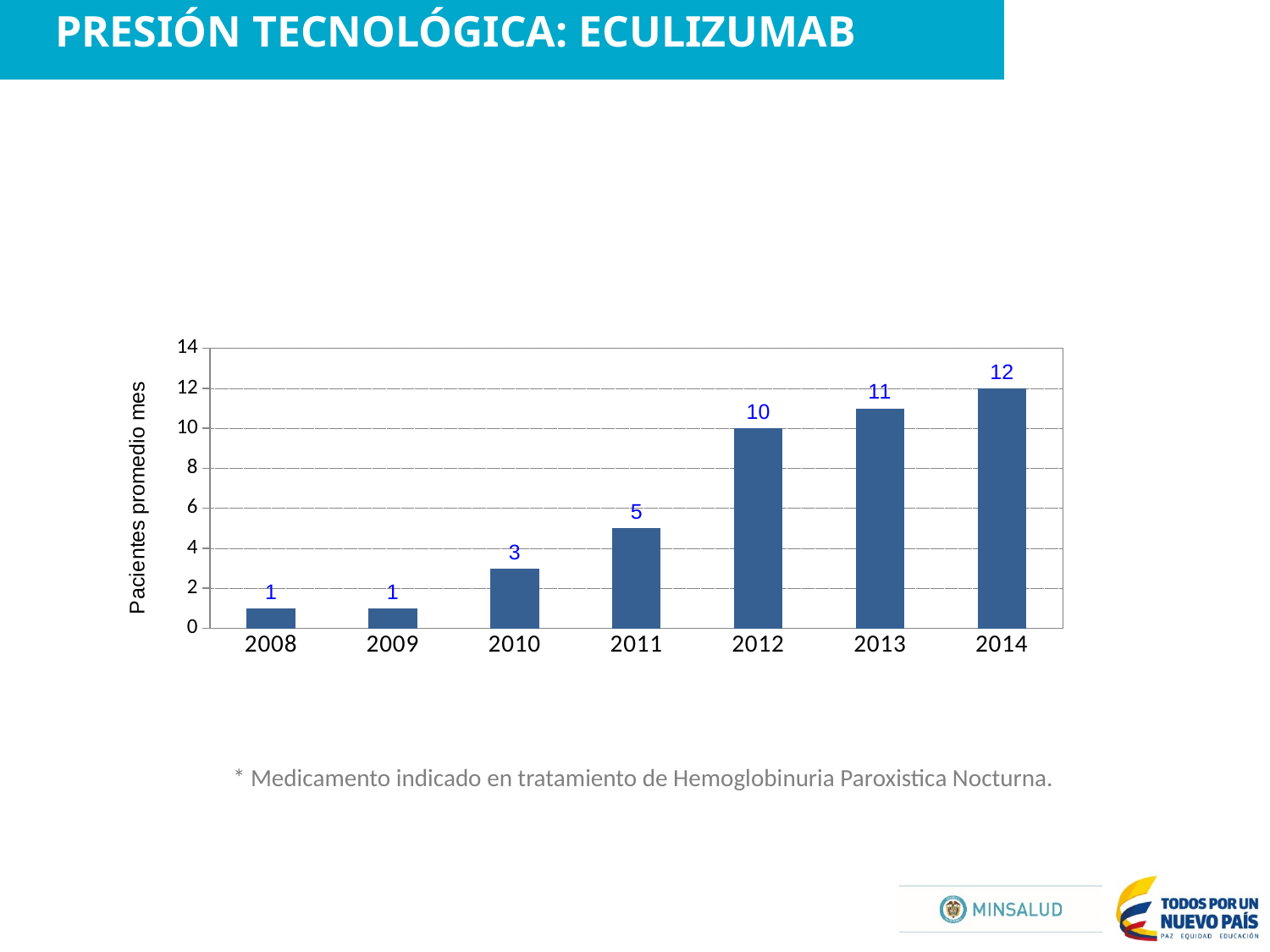
Which year has the highest value? 2014 What is the label of the y axis? Pacientes promedio mes What is the difference between the values for 2013 and 2012? 1 What is the value for 2010? 3 What kind of chart is shown on the slide? bar chart Is the value for 2013 greater or less than 8? greater What is the value for 2012? 10 Do the values rise or fall from 2008 to 2014? rise How many years are shown on the x axis? 7 What is the value for 2014? 12 Which is larger, the value for 2011 or the value for 2010? 2011 What is the difference between the values for 2014 and 2011? 7